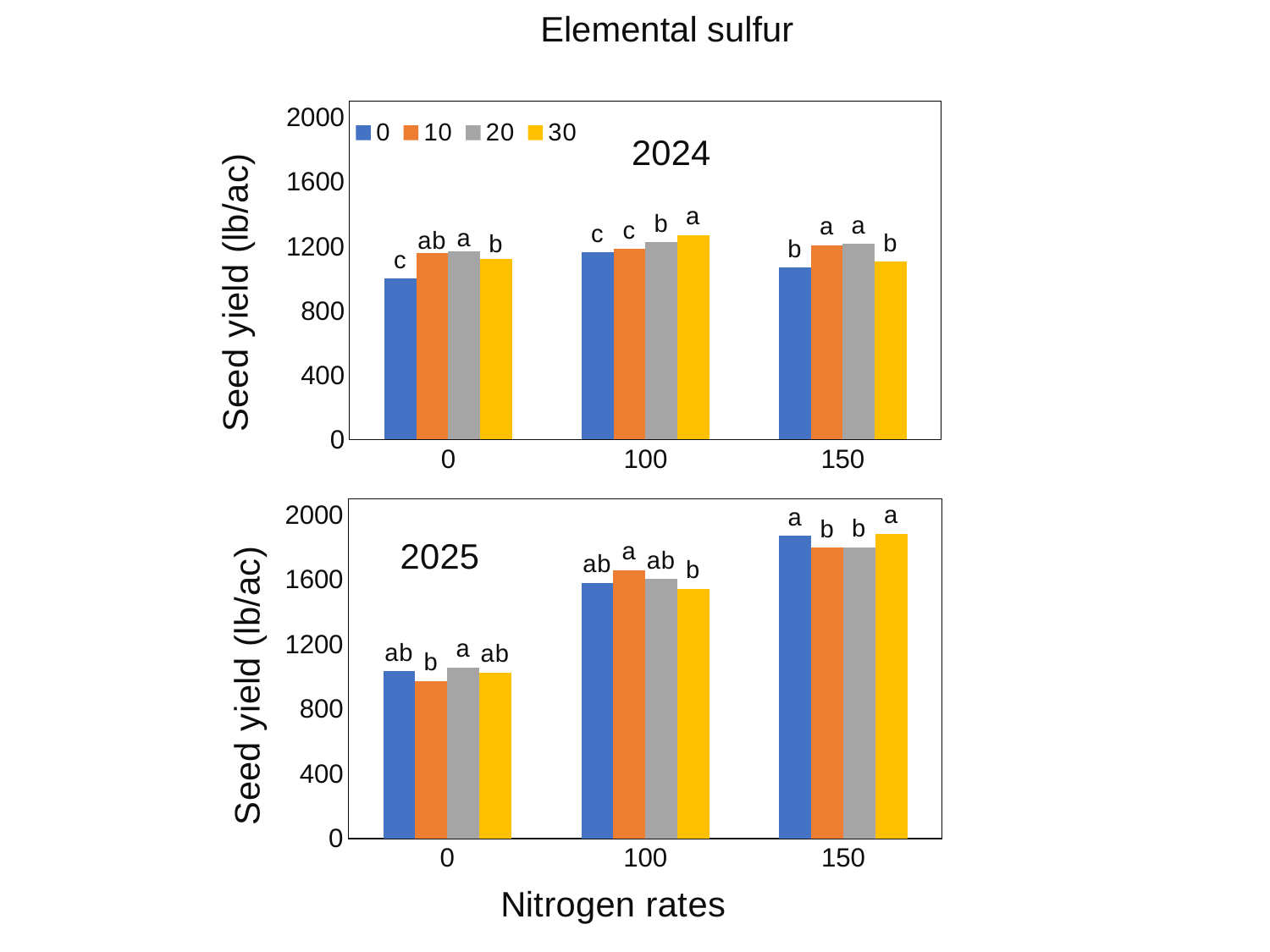
In the 2024 chart, which series has the lowest value at nitrogen rate 0? 0 In the 2025 chart, which series has the lowest value at nitrogen rate 0? 10 How many nitrogen rate categories are shown on the x axis of the 2025 chart? 3 What is the title shown at the top of the slide above the charts? Elemental sulfur In the 2024 chart, is the value for series 0 at nitrogen rate 0 greater or less than 1200? less In the 2025 chart, is the value for series 10 at nitrogen rate 0 greater or less than 1200? less In the 2025 chart, do the values for series 0 rise or fall as the nitrogen rate increases from 0 to 150? rise How many series does the legend in the 2024 chart list? 4 In the 2024 chart, is the value for series 30 at nitrogen rate 100 greater or less than 1200? greater What type of chart is used for the 2024 and 2025 panels on this slide? bar chart In the 2025 chart, which is larger at nitrogen rate 100: series 10 or series 30? series 10